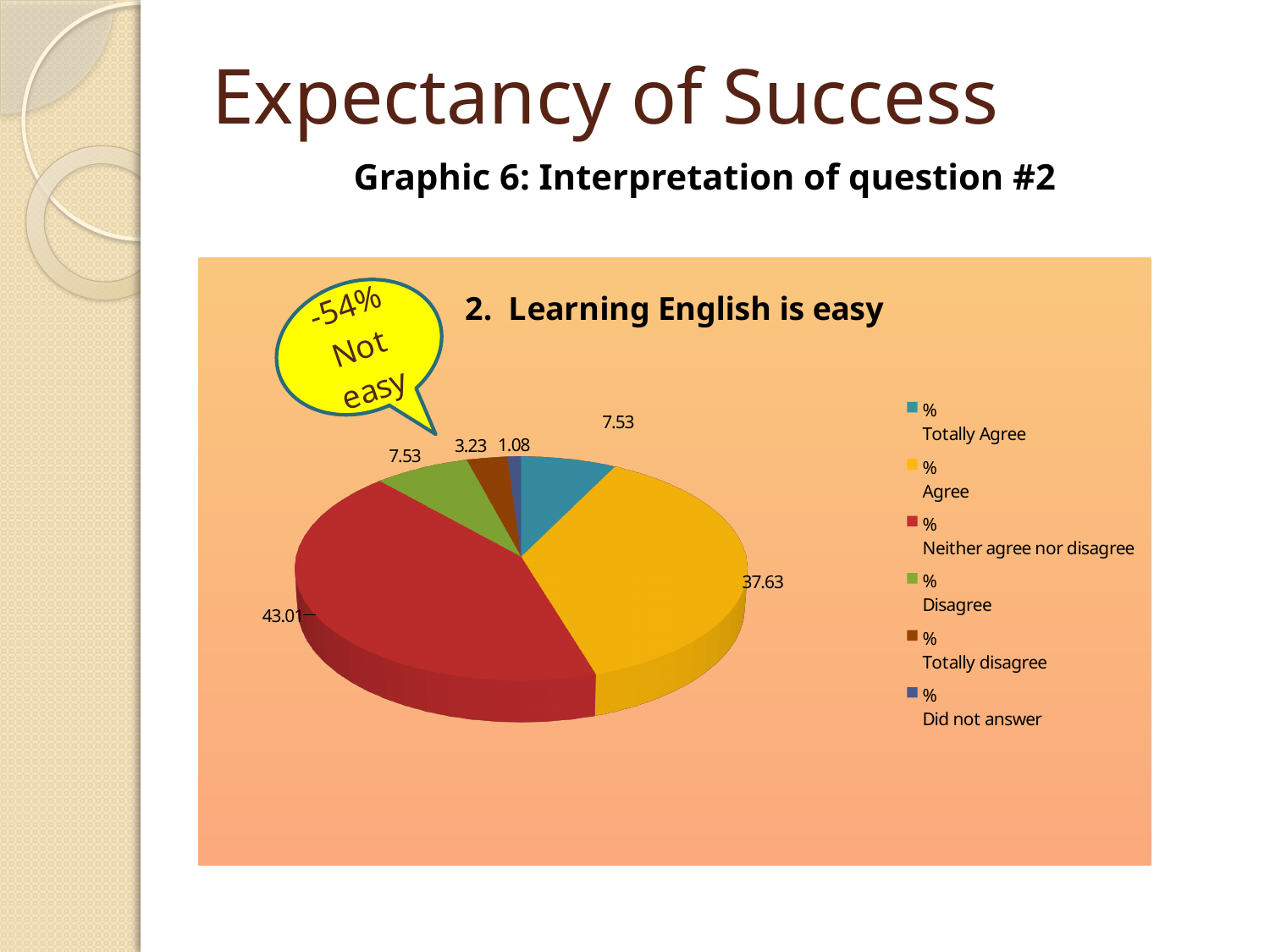
What kind of chart is shown on the slide? Pie chart What is the value for Neither agree nor disagree? 43.01 What is the value for Did not answer? 1.08 How many categories does the legend list? 6 What is the value for Totally disagree? 3.23 What is the difference between the values for Neither agree nor disagree and Agree? 5.38 What colour is the slice for Neither agree nor disagree? Red Which category has the smallest slice of the pie? Did not answer Which is larger, the value for Agree or the value for Totally Agree? Agree Which category has the largest slice of the pie? Neither agree nor disagree What is the value for Agree? 37.63 What is the title shown above the pie chart? 2. Learning English is easy